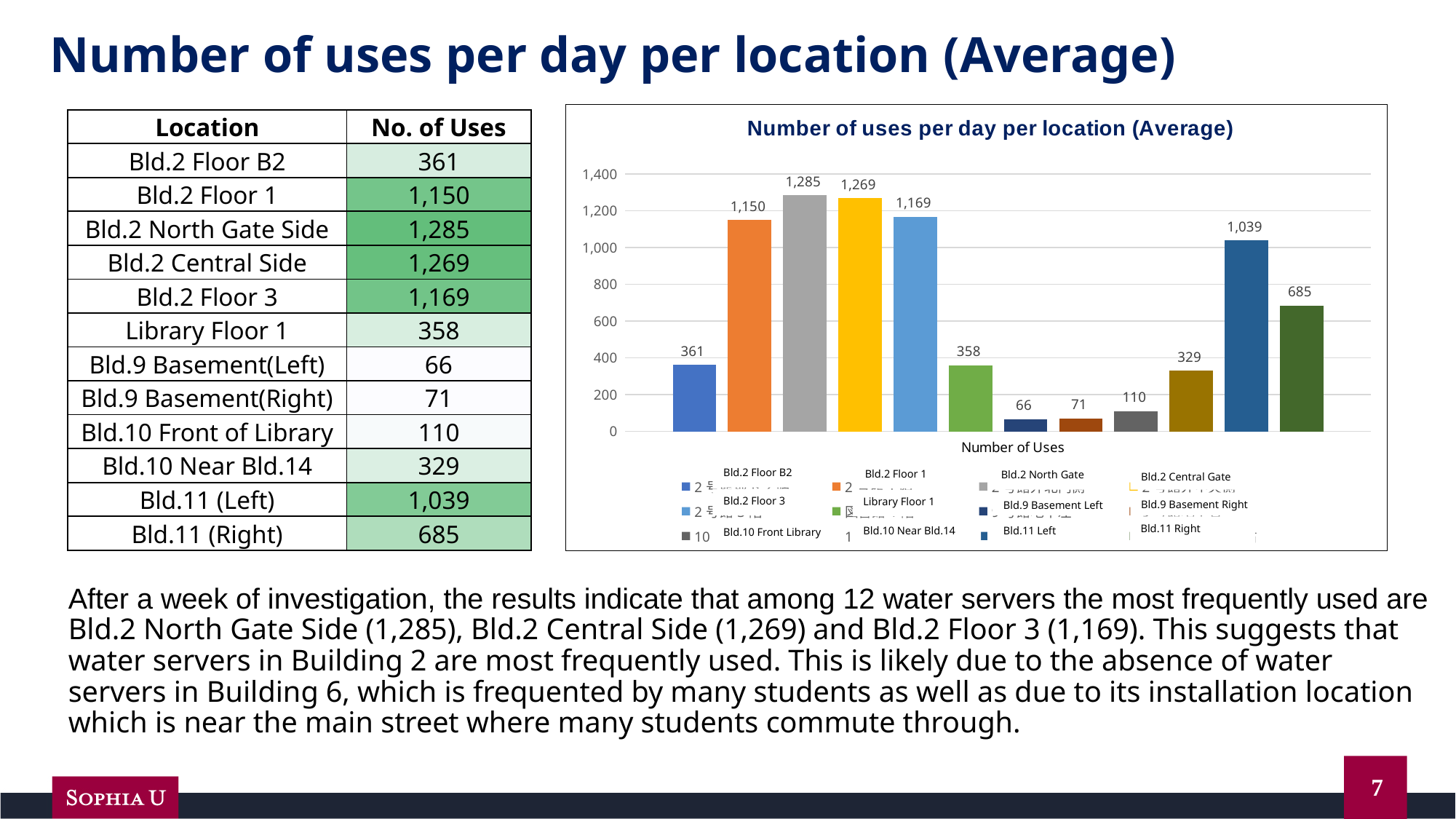
What type of chart is shown on the slide? bar chart What is the title of the chart? Number of uses per day per location (Average) What is the value for Bld.2 North Gate in the chart? 1,285 Which location has the lowest value in the chart? Bld.9 Basement Left What is the value for Bld.11 Left in the chart? 1,039 Which is larger, the value for Bld.2 Floor 1 or the value for Bld.2 Floor 3? Bld.2 Floor 3 How many series does the chart legend list? 12 Is the value for Bld.10 Near Bld.14 greater or less than 400? less How many bars are plotted in the chart? 12 What is the value for Library Floor 1 in the chart? 358 What is the difference between the values for Bld.11 Left and Bld.11 Right? 354 Which location has the highest value in the chart? Bld.2 North Gate